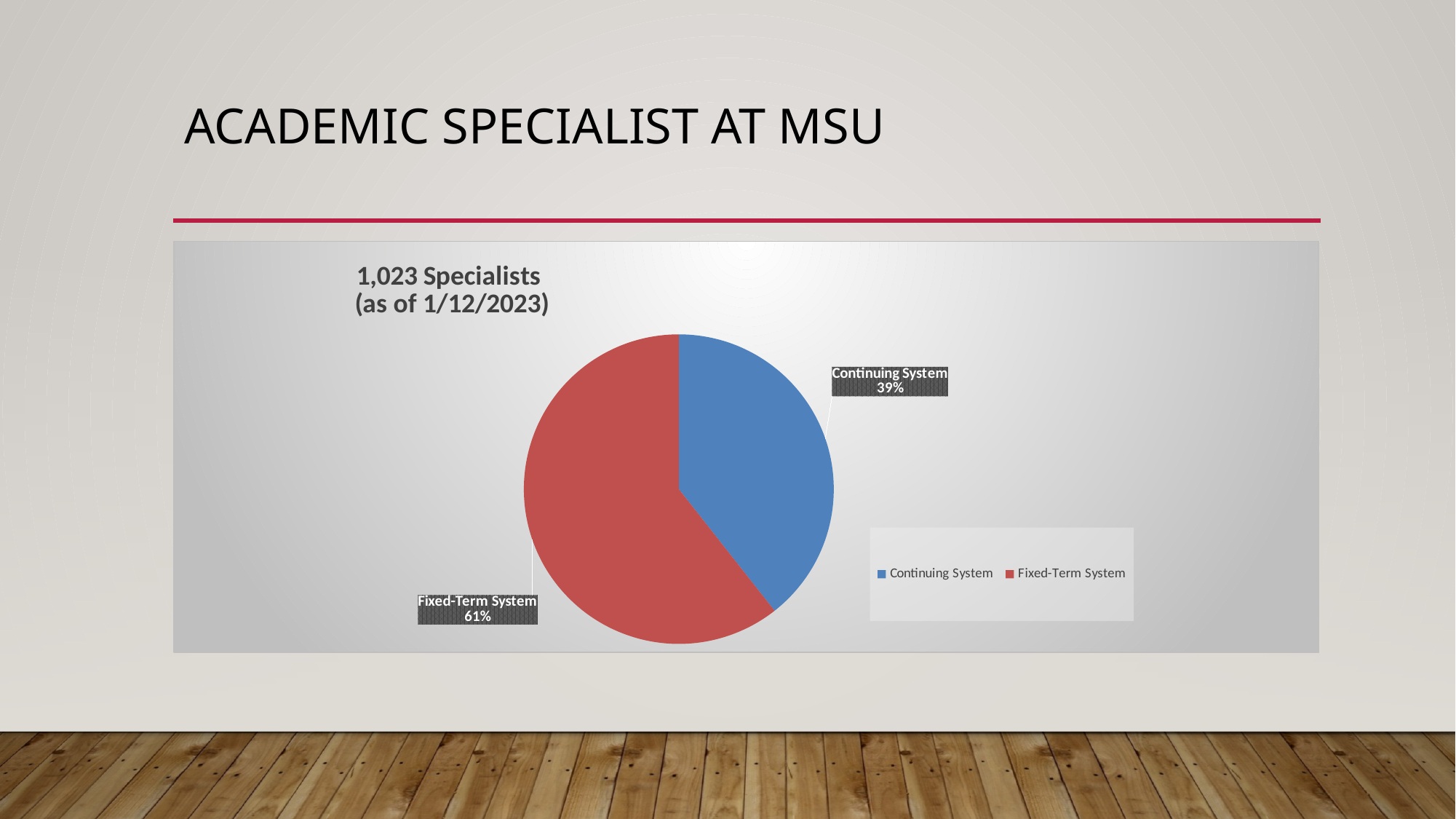
Which is larger, the Continuing System slice or the Fixed-Term System slice? Fixed-Term System What is the difference in percentage points between the Fixed-Term System and Continuing System slices? 22 What is the title of the chart? 1,023 Specialists (as of 1/12/2023) How many categories are shown in the pie chart? 2 Which category has the largest slice of the pie? Fixed-Term System How many entries does the legend list? 2 What colour is the Fixed-Term System slice? Red Is the Continuing System share greater or less than 50%? less Which category has the smallest slice of the pie? Continuing System What share of the pie does Fixed-Term System represent? 61% What share of the pie does Continuing System represent? 39% What kind of chart is shown on the slide? Pie chart